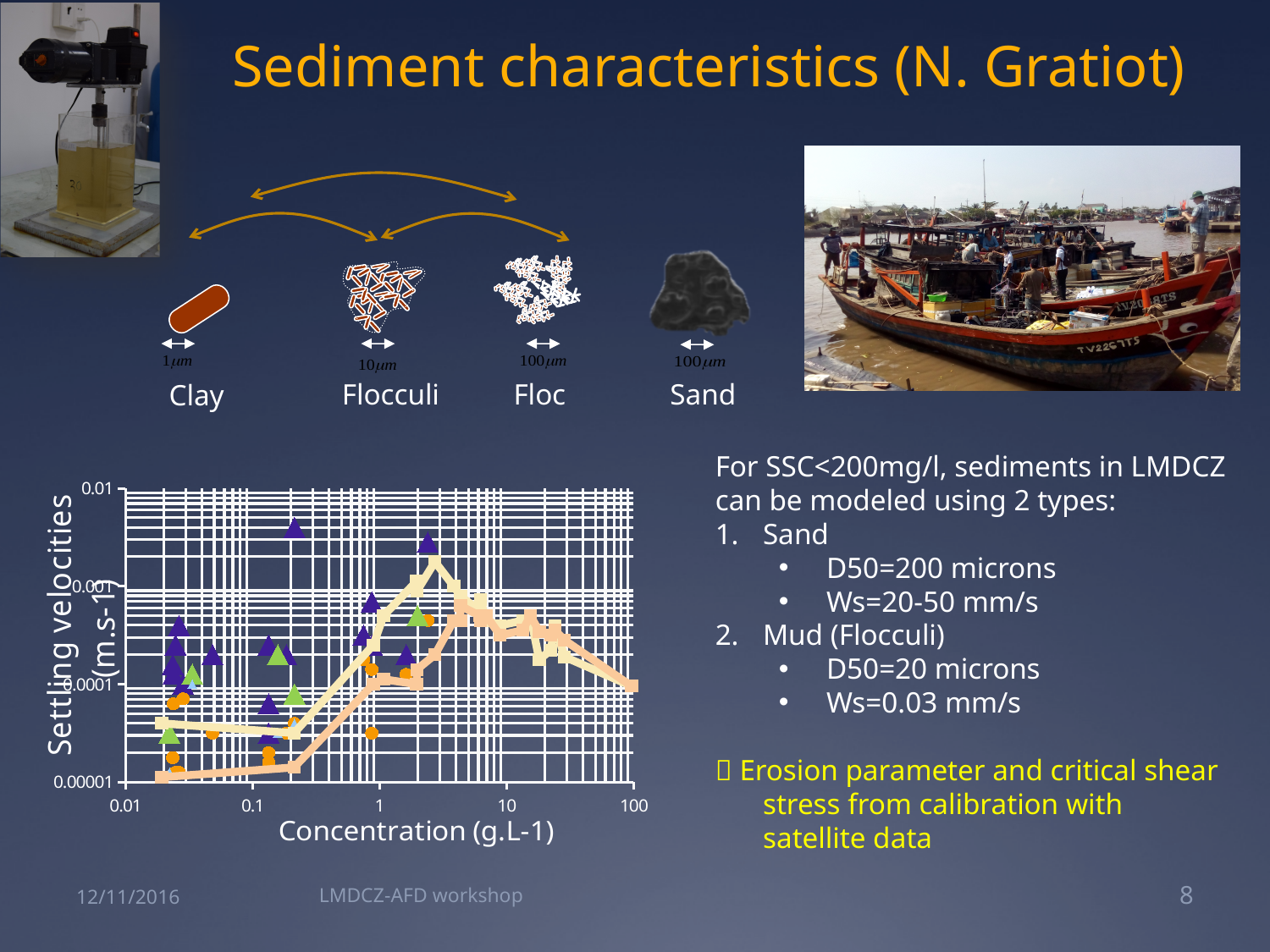
What is the highest value labelled on the x axis of the chart? 100 What is the lowest value labelled on the y axis of the chart? 0.00001 How many tick labels are shown on the y axis of the chart? 4 What is the title of the x axis of the chart? Concentration (g.L-1) Is the settling velocity of the lowest orange circle point near concentration 0.02 greater or less than 0.0001? less Is the settling velocity of the highest purple triangle point greater or less than 0.001? greater What is the title of the y axis of the chart? Settling velocities (m.s-1) What kind of chart is shown at the bottom left of the slide? scatter chart Does the upper peach line rise or fall as concentration increases from 10 to 100? fall Does the upper peach line rise or fall as concentration increases from 0.1 to 1? rise Is the peak of the upper peach line, near concentration 3, greater or less than 0.001? greater How many tick labels are shown on the x axis of the chart? 5